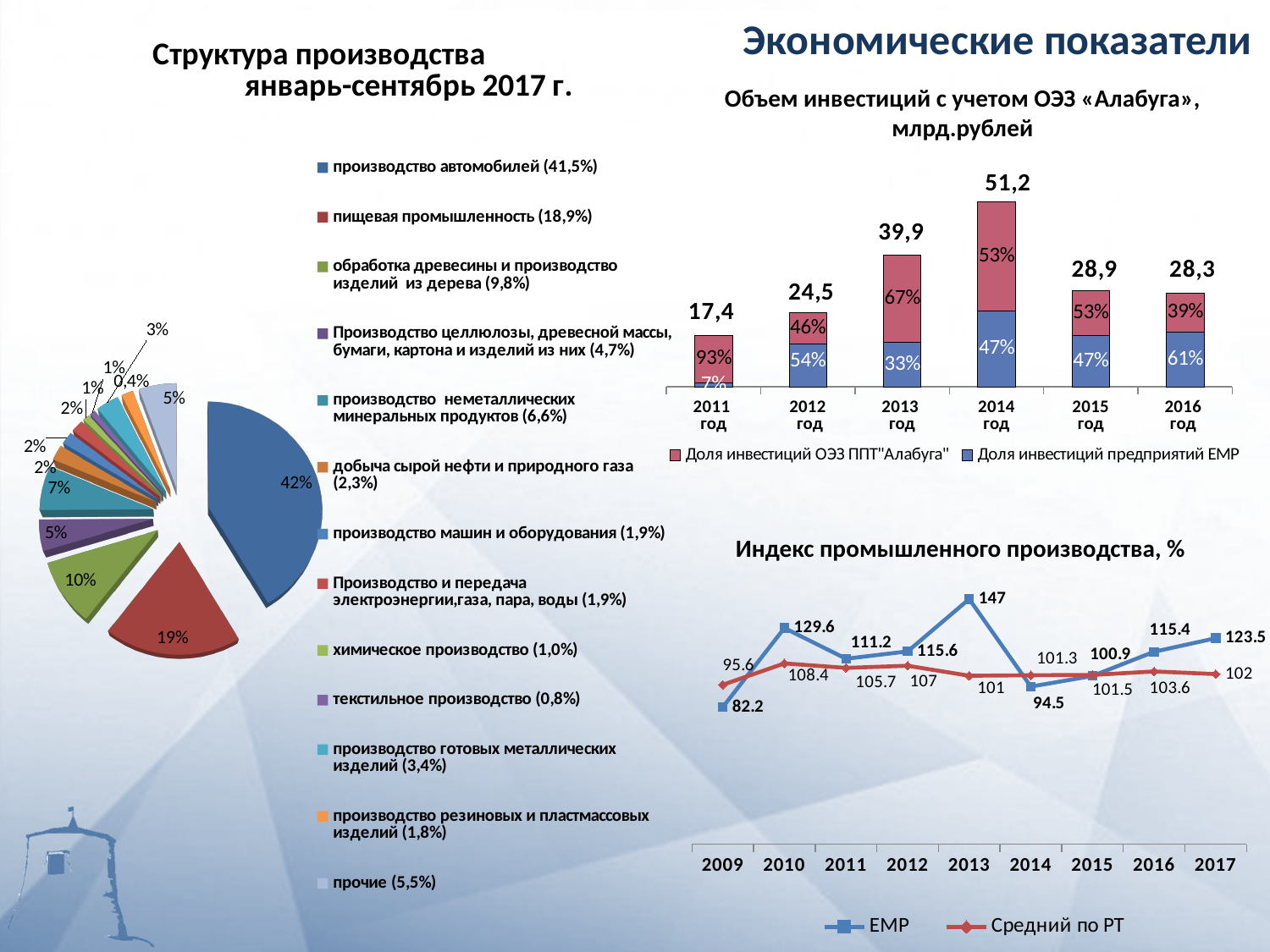
On the chart 'Объем инвестиций с учетом ОЭЗ «Алабуга», млрд.рублей', what is the total value for 2014 год? 51,2 On the chart 'Индекс промышленного производства, %', in which year is the ЕМР series lowest? 2009 On the pie chart 'Структура производства январь-сентябрь 2017 г.', which category has the largest share according to the legend? производство автомобилей (41,5%) On the pie chart 'Структура производства январь-сентябрь 2017 г.', what share does 'пищевая промышленность' have according to the legend? 18,9% On the chart 'Индекс промышленного производства, %', which is larger in 2014: ЕМР or Средний по РТ? Средний по РТ On the chart 'Объем инвестиций с учетом ОЭЗ «Алабуга», млрд.рублей', what is the difference between the totals for 2014 год and 2013 год? 11,3 On the chart 'Объем инвестиций с учетом ОЭЗ «Алабуга», млрд.рублей', which year has the lowest total investment? 2011 год On the chart 'Объем инвестиций с учетом ОЭЗ «Алабуга», млрд.рублей', how many years are shown on the x axis? 6 On the chart 'Индекс промышленного производства, %', what is the value of the ЕМР series in 2013? 147 On the chart 'Индекс промышленного производства, %', what kind of chart is it? line chart On the chart 'Индекс промышленного производства, %', how many series does the legend list? 2 On the chart 'Объем инвестиций с учетом ОЭЗ «Алабуга», млрд.рублей', what share of the 2016 год bar is 'Доля инвестиций предприятий ЕМР'? 61%